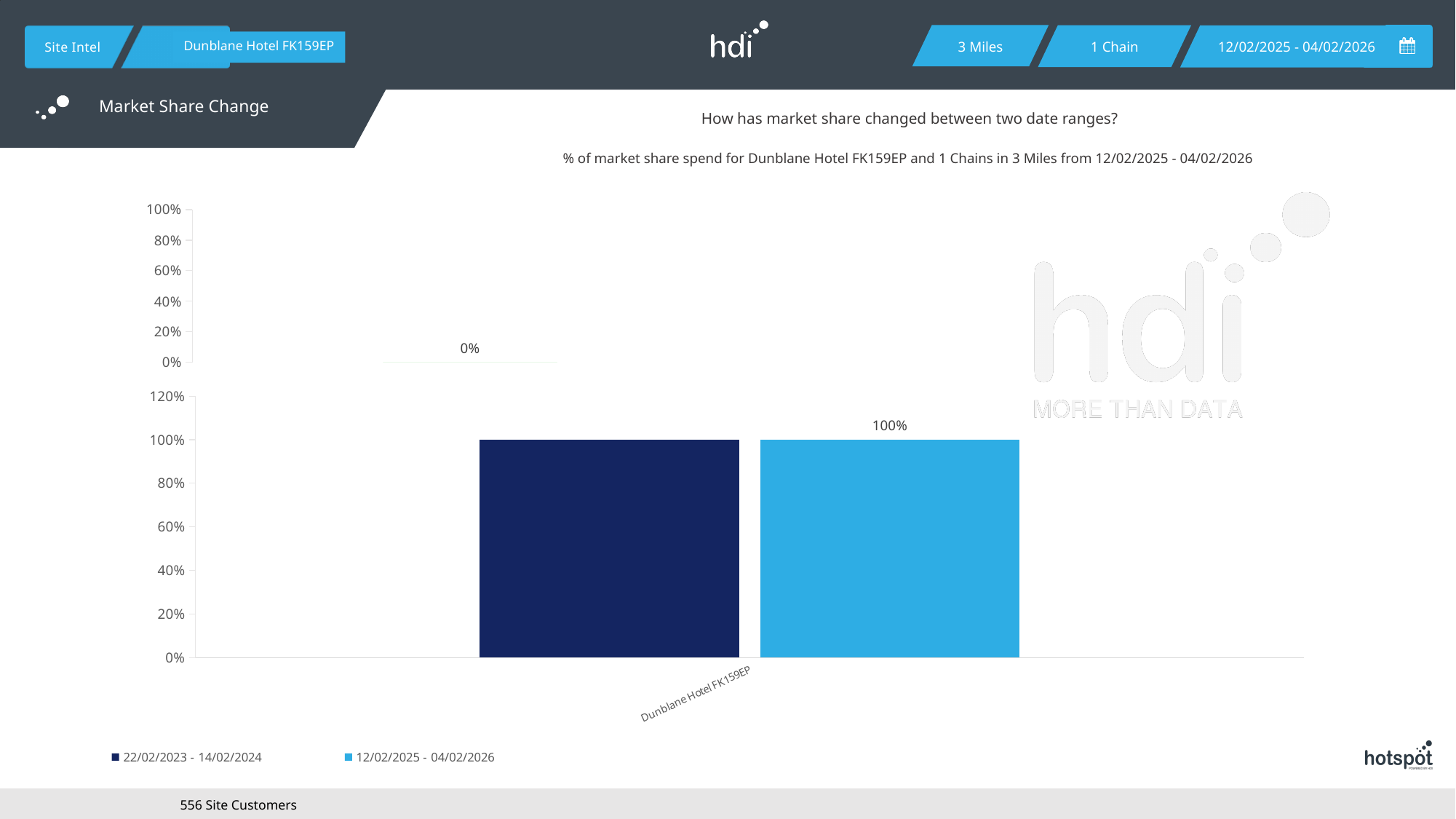
On the bottom chart, how many categories are shown on the x axis? 1 On the bottom chart, what is the value for the 12/02/2025 - 04/02/2026 series for Dunblane Hotel FK159EP? 100% What are the two legend entries on the bottom chart? 22/02/2023 - 14/02/2024 and 12/02/2025 - 04/02/2026 On the bottom chart, is the value for the 22/02/2023 - 14/02/2024 series greater or less than 60%? greater On the top chart, what value is printed as the data label? 0% What is the category label on the x axis of the bottom chart? Dunblane Hotel FK159EP On the bottom chart, what is the difference between the 12/02/2025 - 04/02/2026 value and the 22/02/2023 - 14/02/2024 value for Dunblane Hotel FK159EP? 0% On the bottom chart, is the value for the 12/02/2025 - 04/02/2026 series greater or less than 80%? greater On the bottom chart, what is the value for the 22/02/2023 - 14/02/2024 series for Dunblane Hotel FK159EP? 100% What kind of chart is the bottom chart on the slide? bar chart On the bottom chart, how many series does the legend list? 2